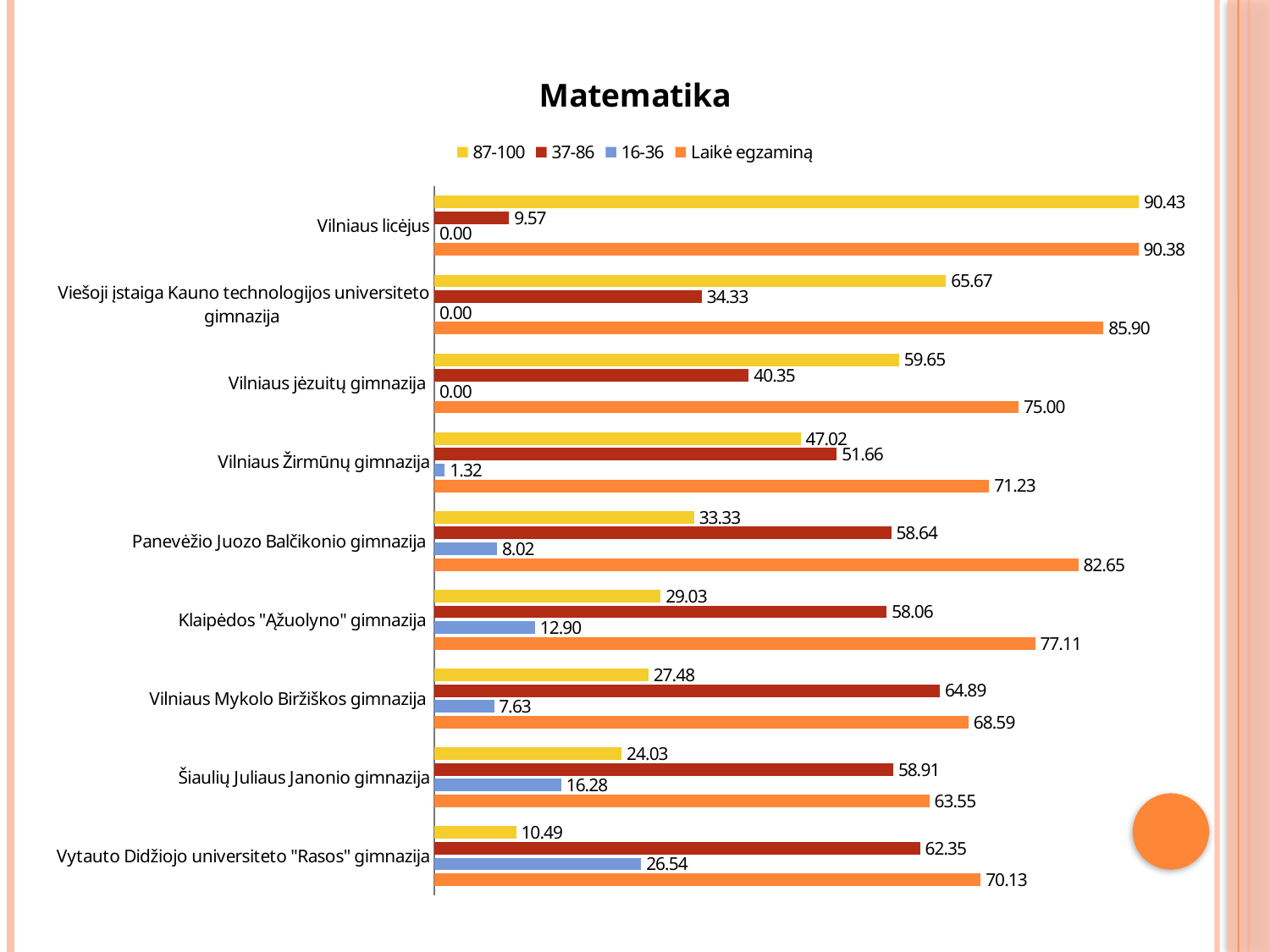
Which is larger for Klaipėdos "Ąžuolyno" gimnazija: the 37-86 value or the 87-100 value? 37-86 What is the value of the 16-36 series for Vytauto Didžiojo universiteto "Rasos" gimnazija? 26.54 What is the value of the 87-100 series for Vilniaus licėjus? 90.43 What is the difference between the 87-100 and 37-86 values for Vilniaus Žirmūnų gimnazija? 4.64 How many series does the legend list? 4 What is the title of the chart? Matematika Which school has the lowest value in the Laikė egzaminą series? Šiaulių Juliaus Janonio gimnazija What kind of chart is shown on the slide? Bar chart What is the value of the Laikė egzaminą series for Vilniaus jėzuitų gimnazija? 75.00 What is the value of the 37-86 series for Panevėžio Juozo Balčikonio gimnazija? 58.64 Which school has the highest value in the 87-100 series? Vilniaus licėjus How many schools are shown on the chart? 9